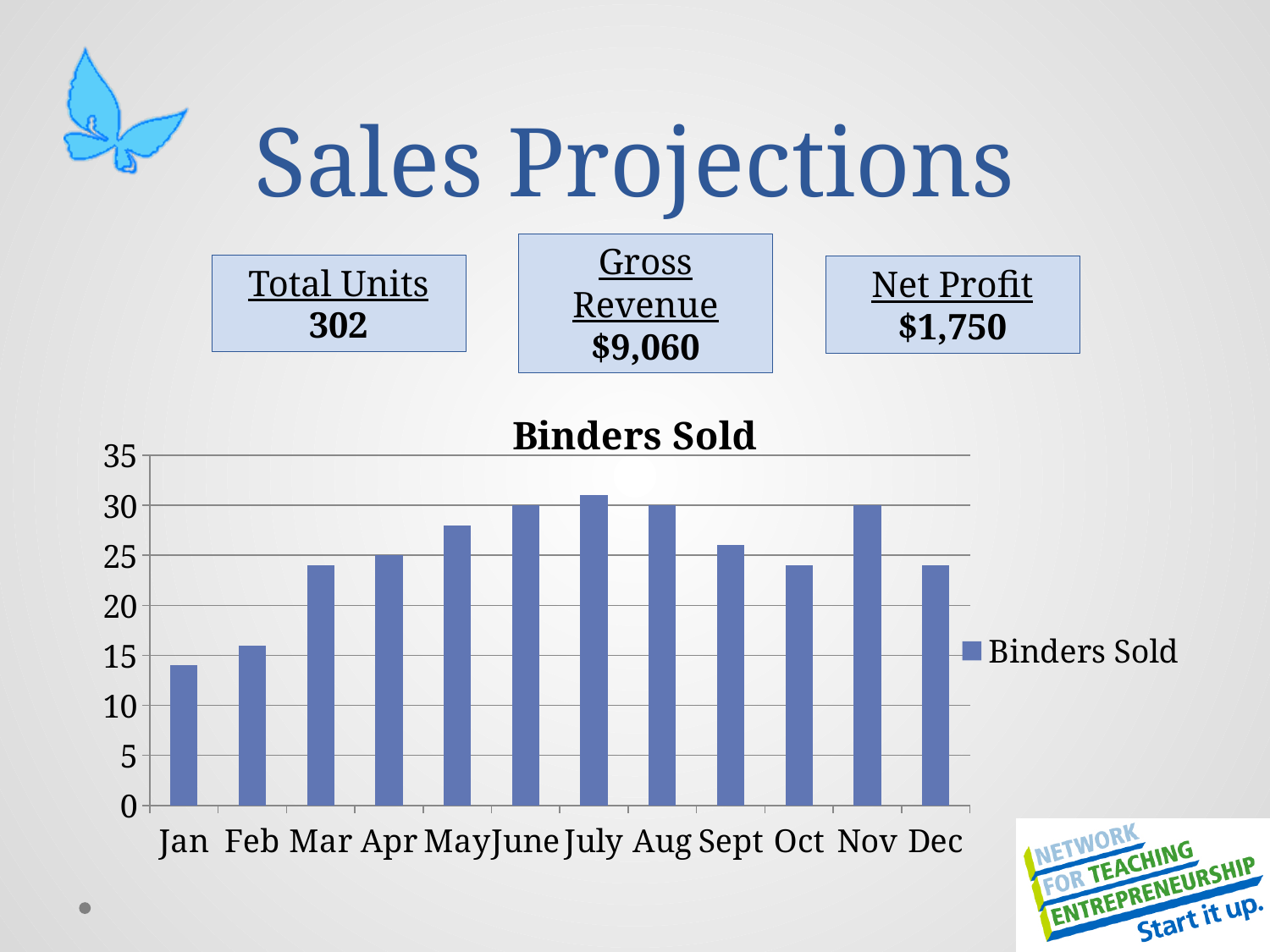
Is the value for July greater or less than 30? greater Which is larger, the value for Mar or the value for Feb? Mar How many months are shown on the x axis of the chart? 12 What kind of chart is shown on the slide? bar chart What is the title of the chart? Binders Sold Do the values rise or fall from Jan to July? rise Is the value for Sept greater or less than 25? greater Is the value for Dec greater or less than 25? less Which month has the lowest number of binders sold? Jan What is the name of the series shown in the legend? Binders Sold How many series does the chart legend list? 1